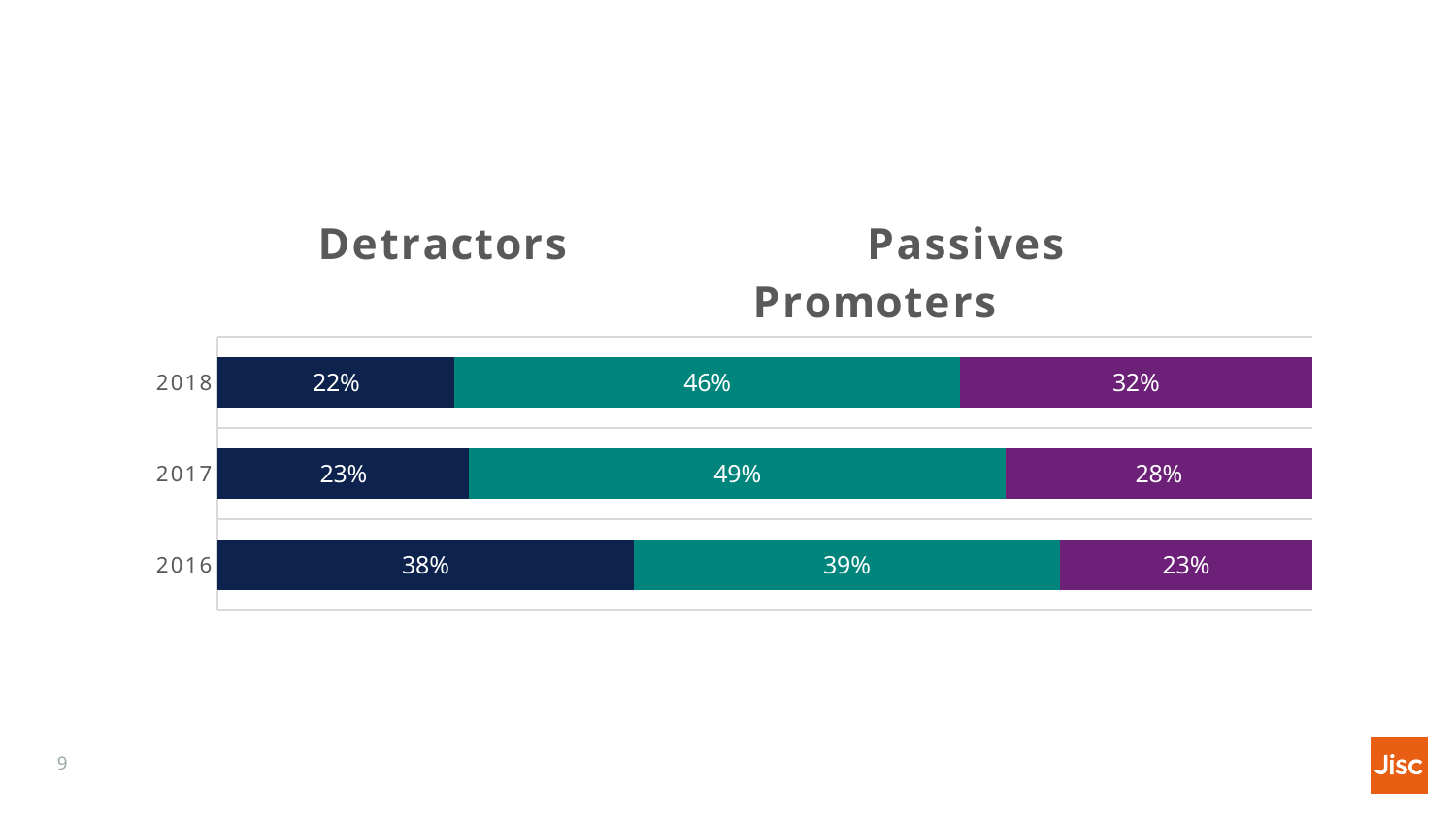
What is the Passives value for 2017? 49% What is the Promoters value for 2018? 32% How many years are shown on the chart? 3 Which is larger, the Promoters value for 2017 or the Promoters value for 2018? 2018 What is the total of the stacked bar for 2016? 100% What kind of chart is shown on the slide? Stacked bar chart Which series is shown in the dark navy colour? Detractors What percentage of Detractors is shown for 2016? 38% Which year has the lowest Promoters percentage? 2016 Which year has the highest Passives percentage? 2017 What is the difference between the Detractors percentage in 2016 and in 2018? 16%